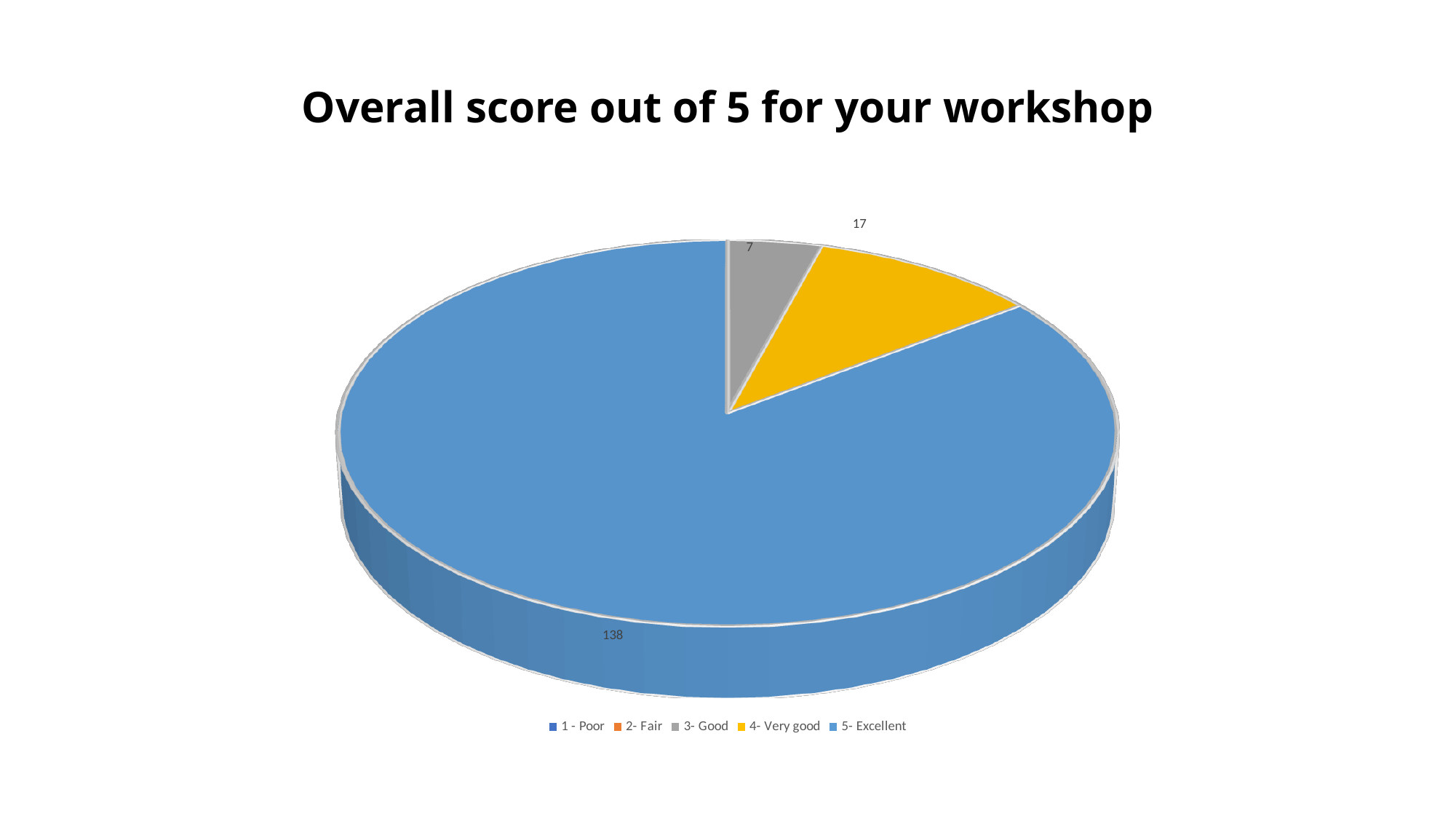
What is the value for 4- Very good? 17 What is the value for 5- Excellent? 138 Which of the slices with a printed value is the smallest? 3- Good What is the value for 3- Good? 7 What colour is the slice for 5- Excellent? blue Which is larger, the value for 4- Very good or the value for 3- Good? 4- Very good How many categories does the legend list? 5 What is the difference between the values for 4- Very good and 3- Good? 10 What is the difference between the values for 5- Excellent and 4- Very good? 121 What kind of chart is shown on the slide? pie chart Which category has the largest slice of the pie? 5- Excellent What is the title of the chart? Overall score out of 5 for your workshop